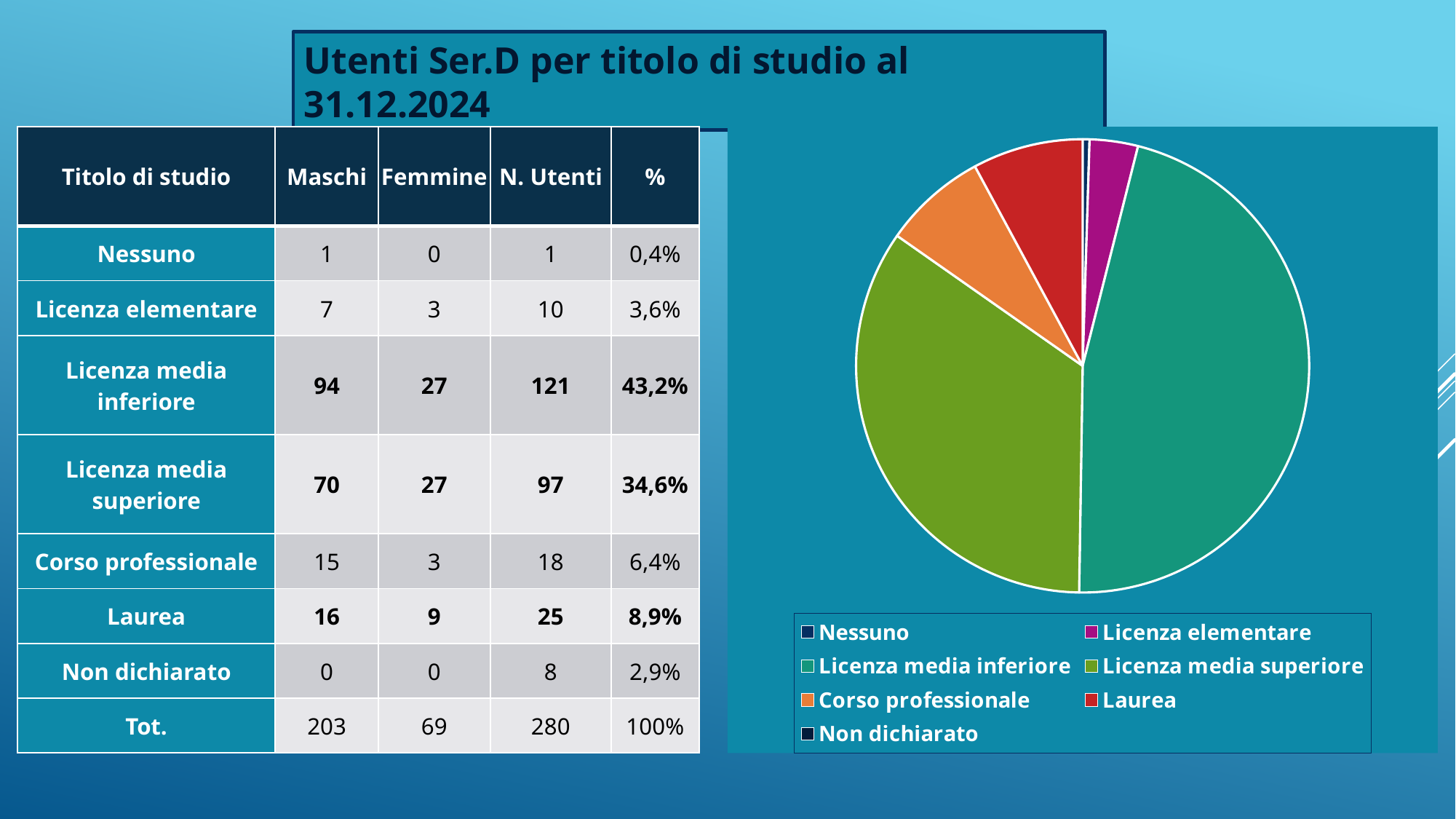
Is the slice for Licenza media inferiore larger or smaller than the slice for Licenza media superiore? larger What colour is the Laurea slice in the pie chart? red According to the table on the slide, what share of users does Licenza media superiore represent? 34,6% Which category has the smallest slice in the pie chart? Nessuno How many categories does the pie chart's legend list? 7 What is the title of the slide's chart section? Utenti Ser.D per titolo di studio al 31.12.2024 According to the table on the slide, what is the total number of users (Tot. N. Utenti)? 280 According to the table on the slide, what share of users does Licenza media inferiore represent? 43,2% Which category has the largest slice in the pie chart? Licenza media inferiore According to the table on the slide, how many users (N. Utenti) have a Laurea? 25 What kind of chart is shown on the slide? pie chart Is the slice for Laurea larger or smaller than the slice for Corso professionale? larger